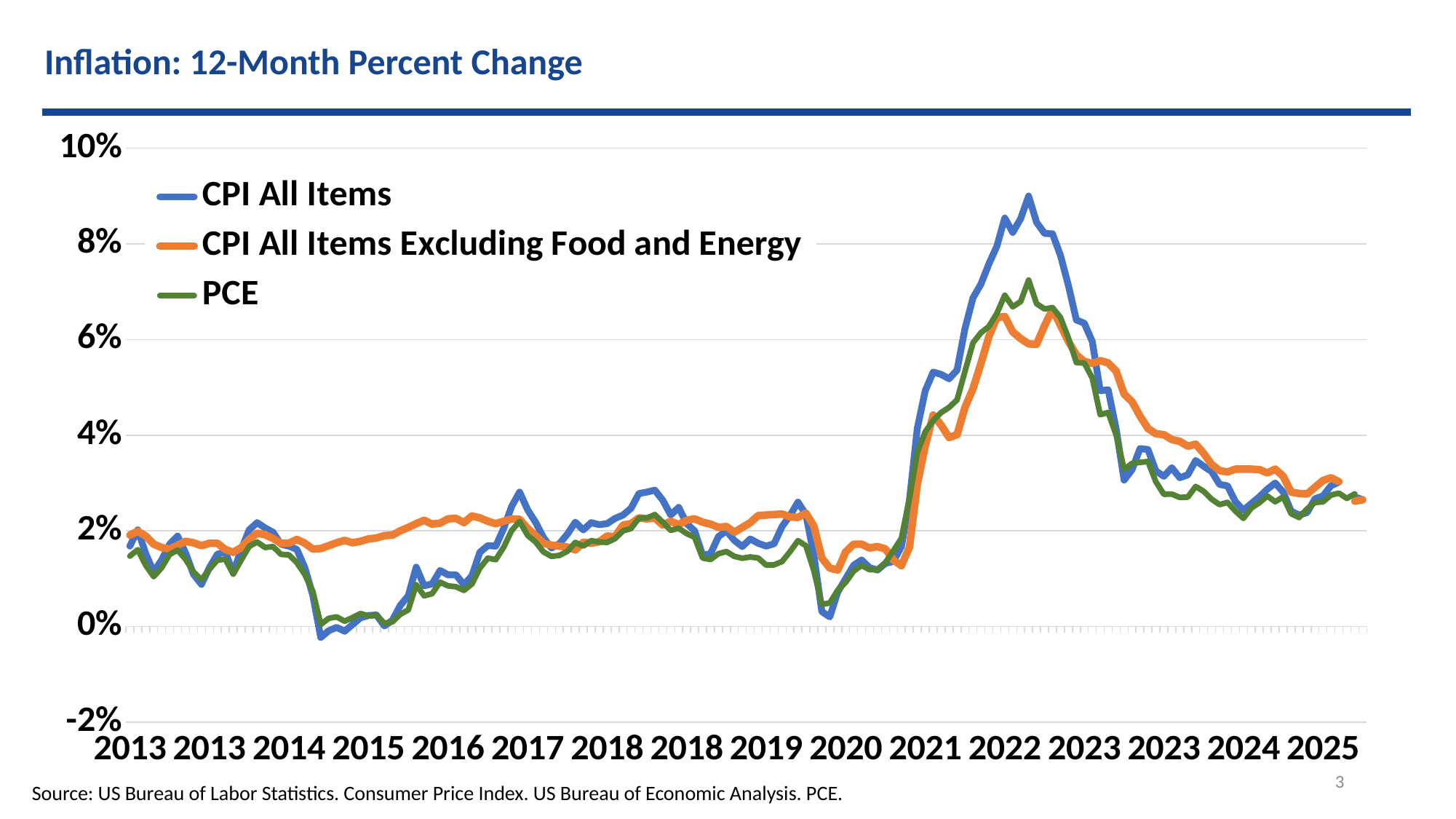
At the 2022 peak, which series is higher, CPI All Items or PCE? CPI All Items How many series does the legend list? 3 From 2020 to 2022, does the CPI All Items line rise or fall? rise Is the peak value of CPI All Items Excluding Food and Energy greater or less than 6%? greater What colour is the PCE line? green Is the peak value of CPI All Items greater or less than 8%? greater What kind of chart is shown on the slide? line chart Is the peak value of PCE greater or less than 8%? less Which series reaches the highest peak on the chart? CPI All Items From its 2022 peak to 2024, does the CPI All Items line rise or fall? fall At the 2022 peak, which series is higher, PCE or CPI All Items Excluding Food and Energy? PCE What is the title of the chart? Inflation: 12-Month Percent Change